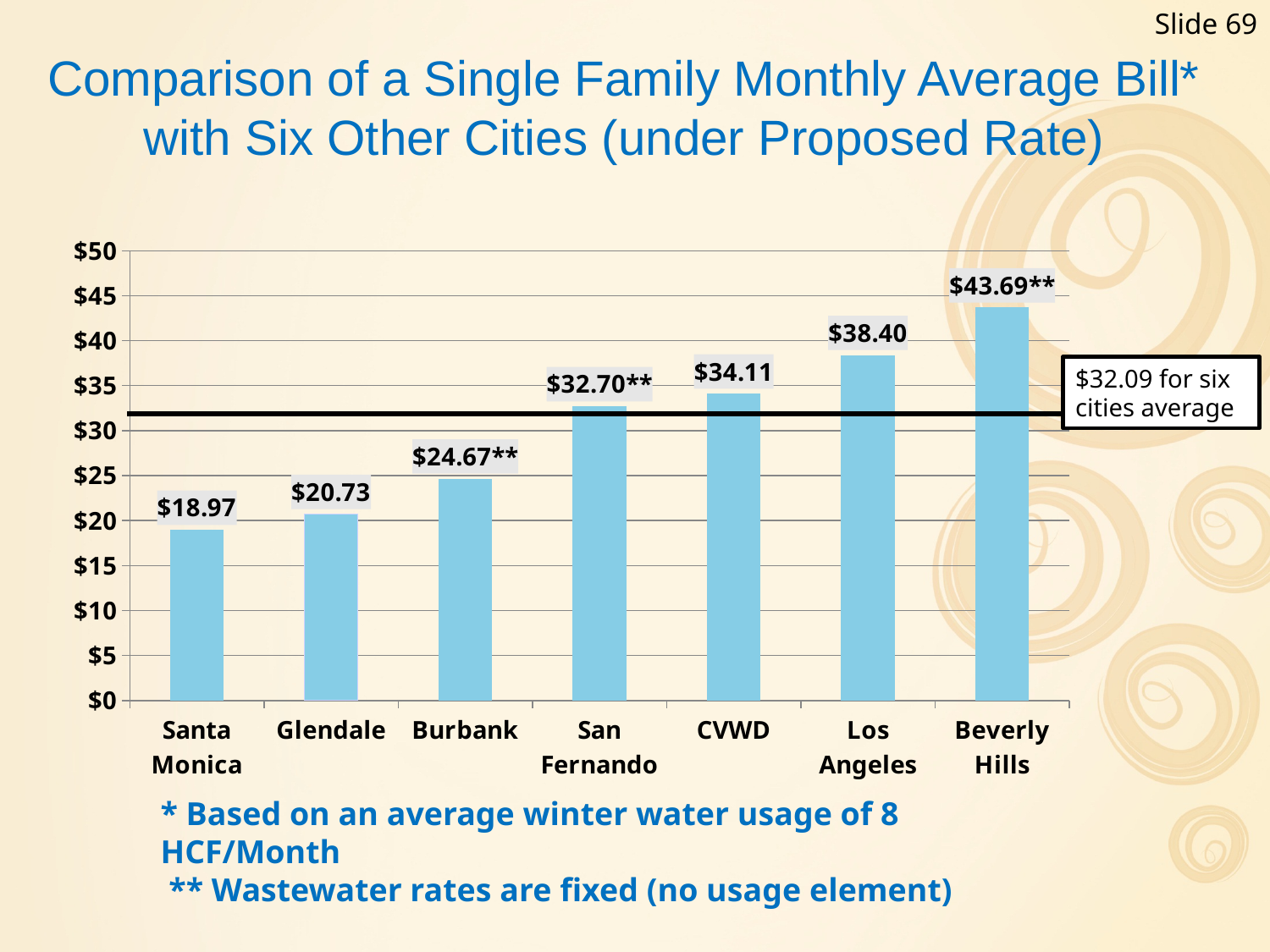
What kind of chart is shown on the slide? Bar chart What value does the horizontal line across the chart represent? $32.09 for six cities average Which city has the highest monthly average bill? Beverly Hills What is the monthly average bill for CVWD? $34.11 Is the value for San Fernando greater or less than $30? greater What is the monthly average bill for Los Angeles? $38.40 Which has a higher monthly average bill, Glendale or Burbank? Burbank Which city has the lowest monthly average bill? Santa Monica What is the difference between the Los Angeles bill and the CVWD bill? $4.29 What is the difference between the Beverly Hills bill and the Santa Monica bill? $24.72 How many cities are shown in the chart? 7 What is the monthly average bill for Santa Monica? $18.97